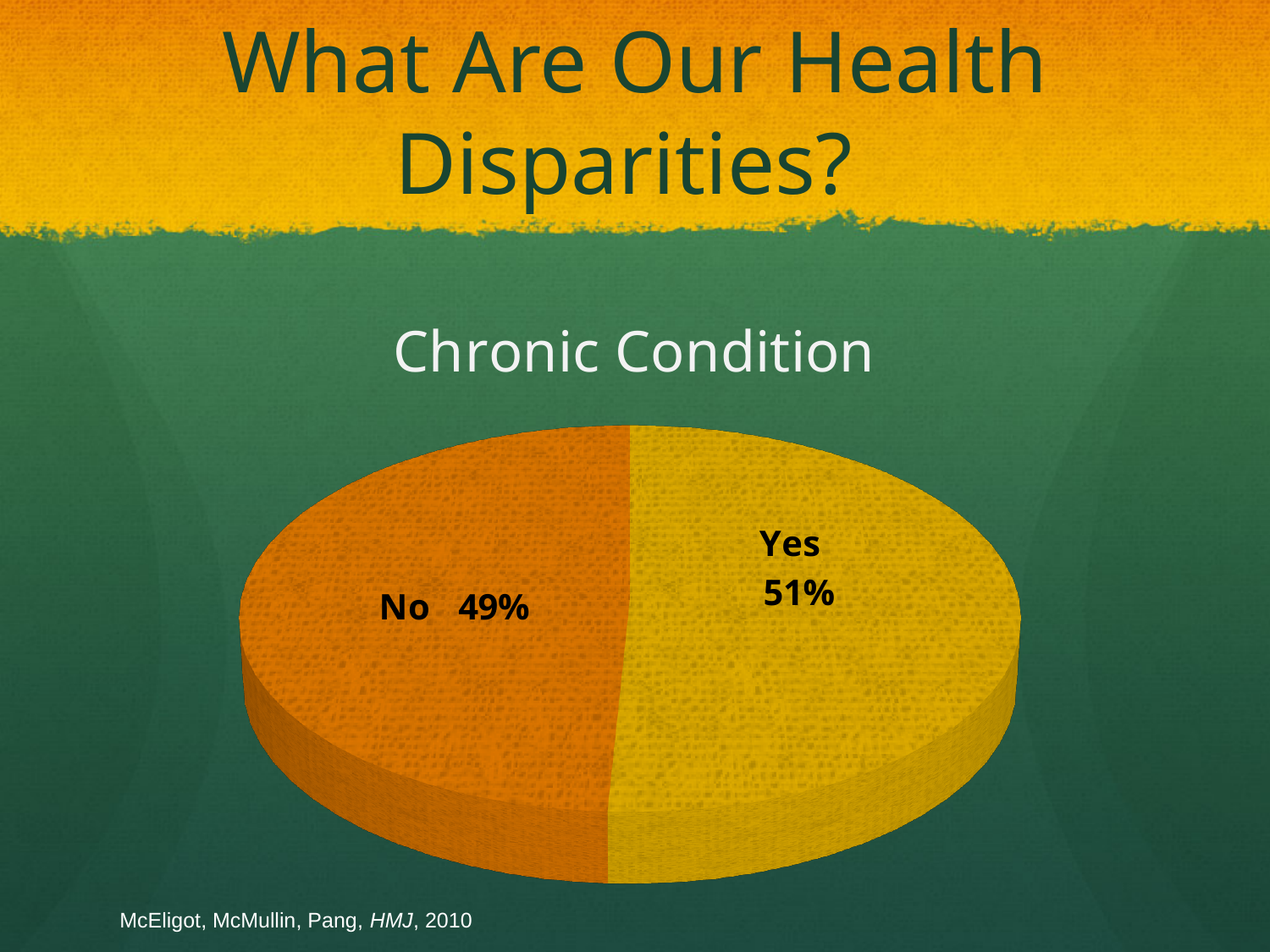
Which slice has the smallest share of the pie? No What share of the pie does the "No" slice represent? 49% What kind of chart is shown on the slide? pie chart How many slices does the pie chart have? 2 What percentage of the pie is labelled "No"? 49% What is the difference in percentage points between the "Yes" and "No" slices? 2 Which slice has the largest share of the pie? Yes Which slice is larger, "Yes" or "No"? Yes What percentage of the pie is labelled "Yes"? 51% What is the title of the chart? Chronic Condition What colour is the "Yes" slice? yellow